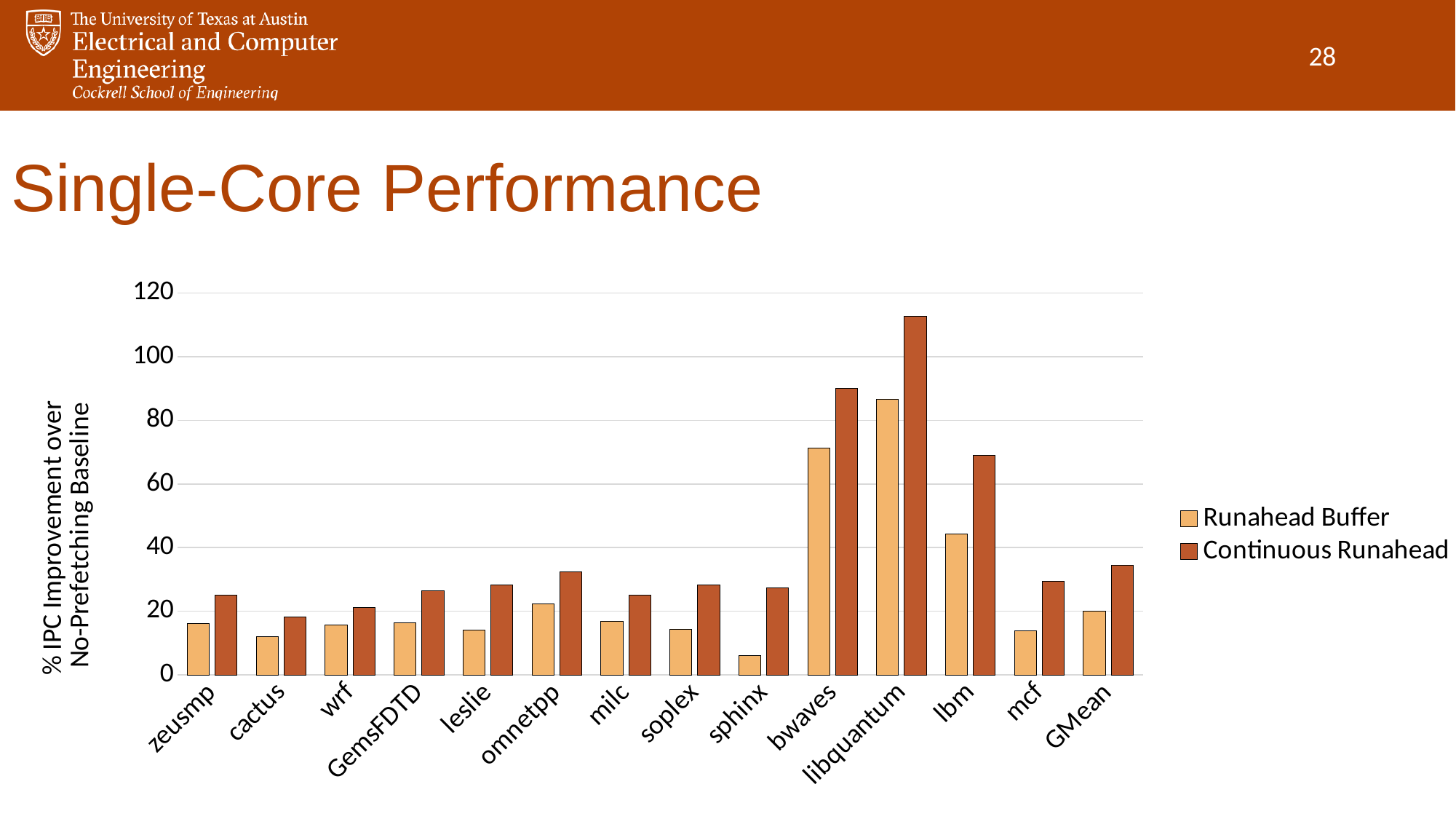
Which has the larger Continuous Runahead value, bwaves or lbm? bwaves How many series does the legend list? 2 Which category has the lowest Runahead Buffer value? sphinx Is the Continuous Runahead value for libquantum greater or less than 100? greater How many benchmark categories are shown on the x axis? 14 What is the label on the y axis? % IPC Improvement over No-Prefetching Baseline Is the Runahead Buffer value for sphinx greater or less than 20? less Which category has the highest Continuous Runahead value? libquantum What kind of chart is shown on the slide? bar chart Is the Continuous Runahead value for GMean greater or less than 40? less Which category has the highest Runahead Buffer value? libquantum